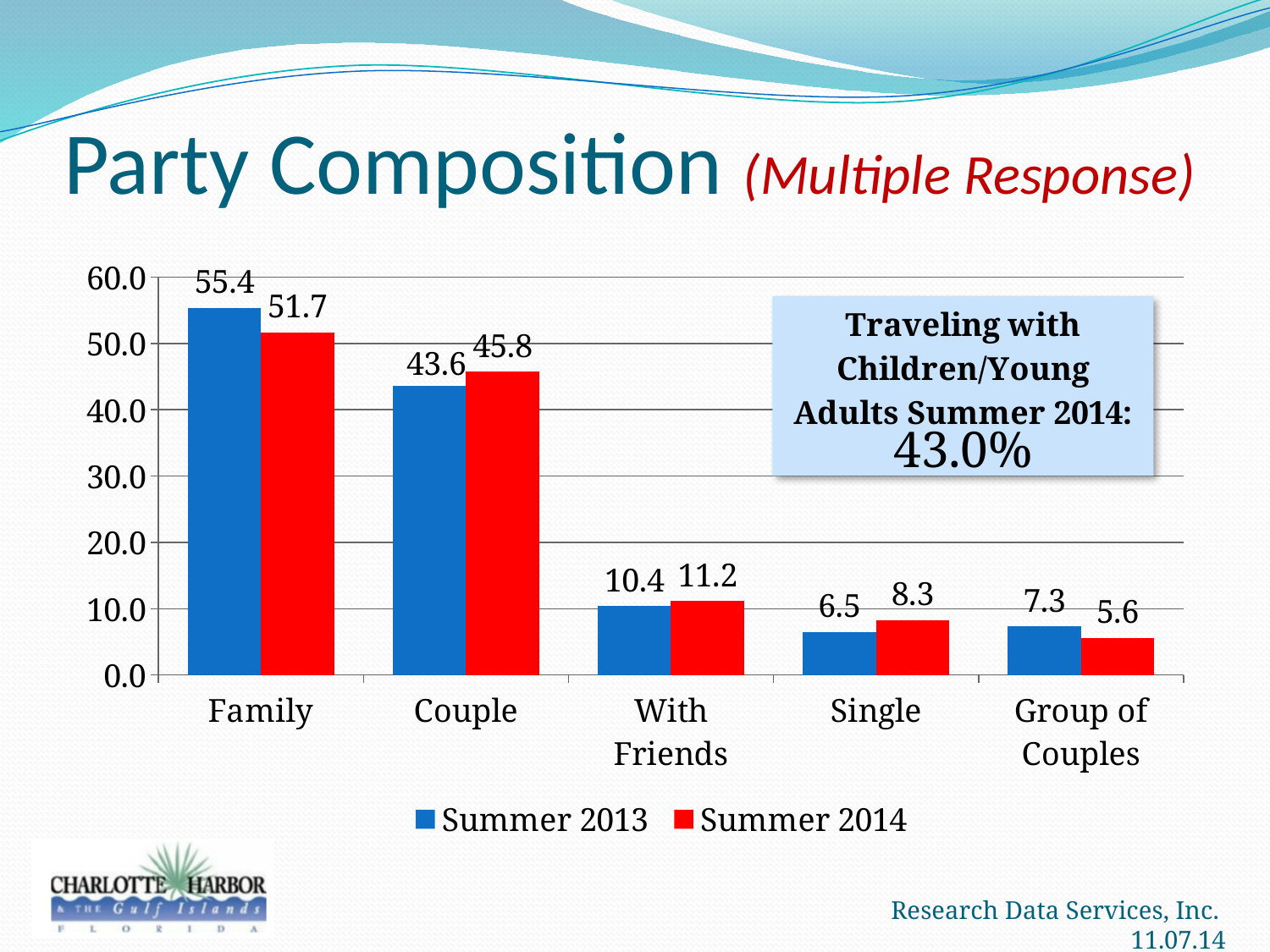
What is the difference between the Summer 2013 and Summer 2014 values for Family? 3.7 Is the Summer 2013 value for Couple greater or less than 40.0? greater How many categories are shown on the x axis? 5 Which category has the lowest Summer 2013 value? Single Which is larger for Single: the Summer 2013 value or the Summer 2014 value? Summer 2014 What kind of chart is shown on the slide? bar chart How many series does the legend list? 2 What is the Summer 2013 value for Family? 55.4 What is the Summer 2014 value for Couple? 45.8 What percentage is given in the text box for Traveling with Children/Young Adults Summer 2014? 43.0% Which category has the highest Summer 2014 value? Family What is the Summer 2014 value for Group of Couples? 5.6